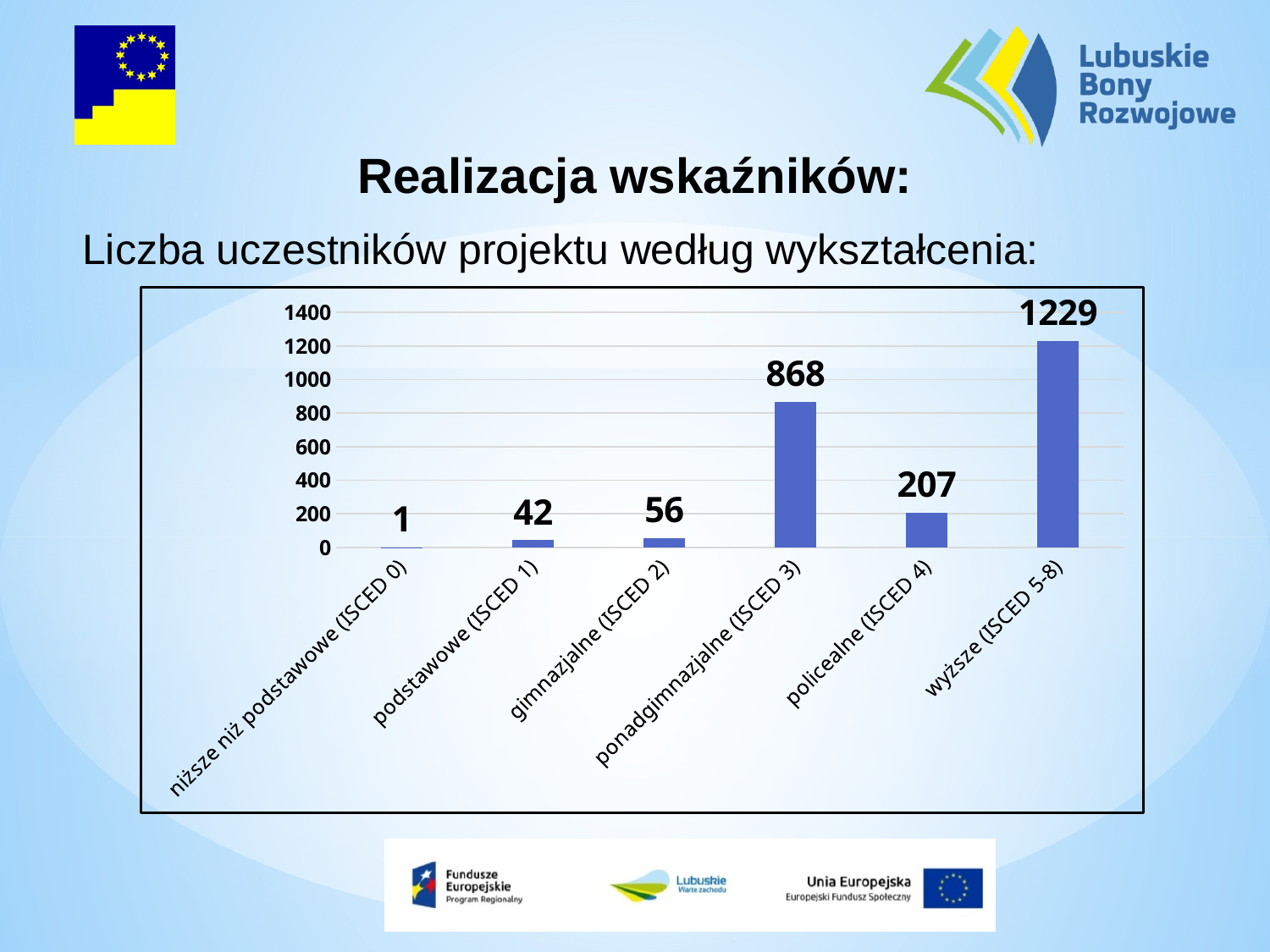
How many categories are shown on the chart? 6 What is the value for ponadgimnazjalne (ISCED 3)? 868 What is the value for wyższe (ISCED 5-8)? 1229 Which is larger, the value for gimnazjalne (ISCED 2) or podstawowe (ISCED 1)? gimnazjalne (ISCED 2) What is the value for policealne (ISCED 4)? 207 What is the subtitle describing the chart? Liczba uczestników projektu według wykształcenia: What kind of chart is shown on the slide? bar chart Is the value for policealne (ISCED 4) greater or less than 400? less What is the value for podstawowe (ISCED 1)? 42 What is the difference between the values for wyższe (ISCED 5-8) and ponadgimnazjalne (ISCED 3)? 361 Which category has the highest value? wyższe (ISCED 5-8) Which category has the lowest value? niższe niż podstawowe (ISCED 0)